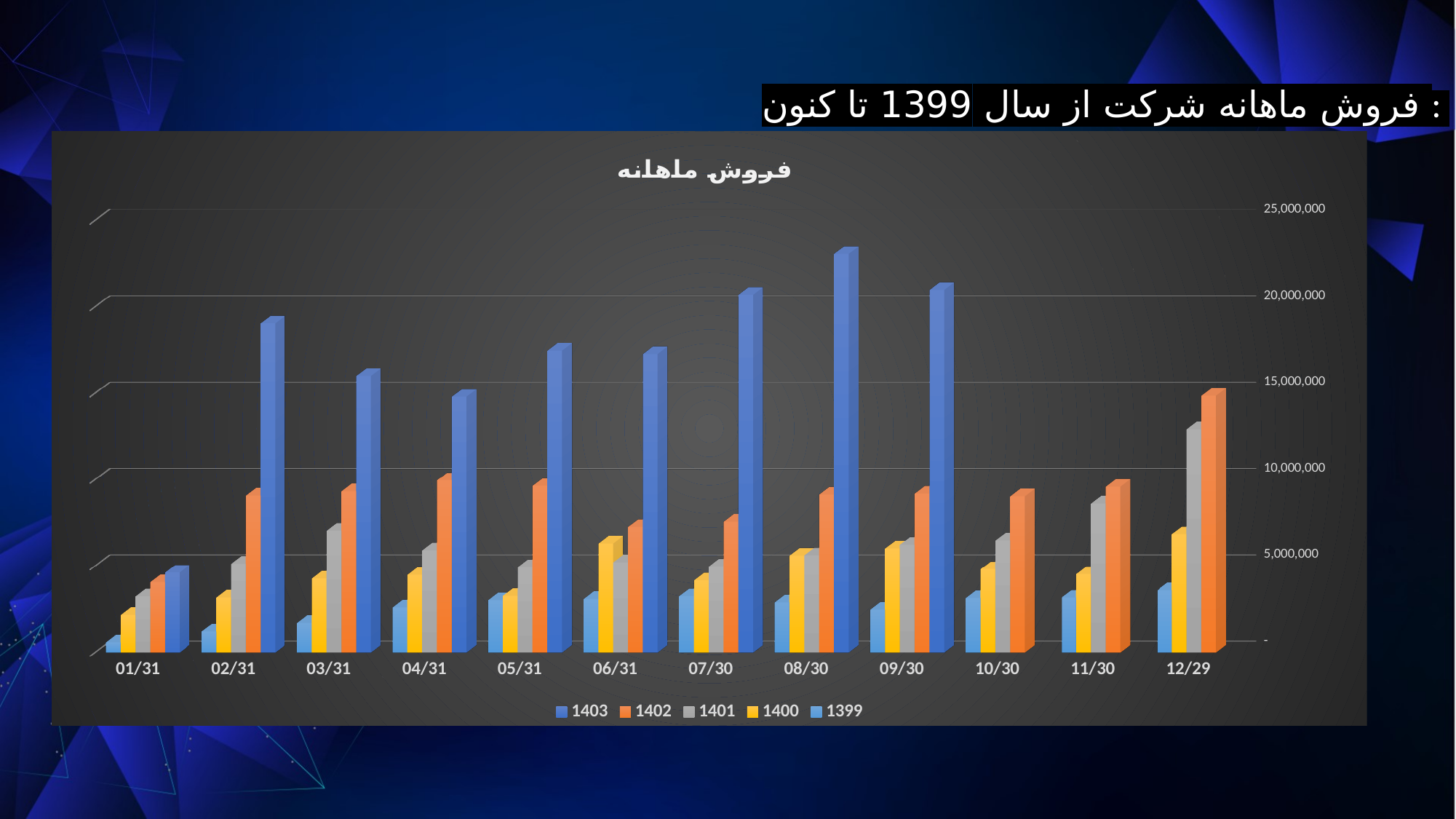
For which category is the 1403 value highest? 08/30 Which series has the highest value at 08/30? 1403 Is the value for 1403 at 08/30 greater or less than 20,000,000? greater How many series does the legend list? 5 Is the value for 1402 at 10/30 greater or less than 10,000,000? less Is the value for 1399 at 01/31 greater or less than 5,000,000? less What is the title of the chart? فروش ماهانه What kind of chart is shown on the slide? Bar chart Which series has the lowest value at 12/29? 1399 At 12/29, which is larger: the value for 1402 or the value for 1401? 1402 How many categories are shown on the x axis? 12 Which series has no bars for 10/30, 11/30 and 12/29? 1403